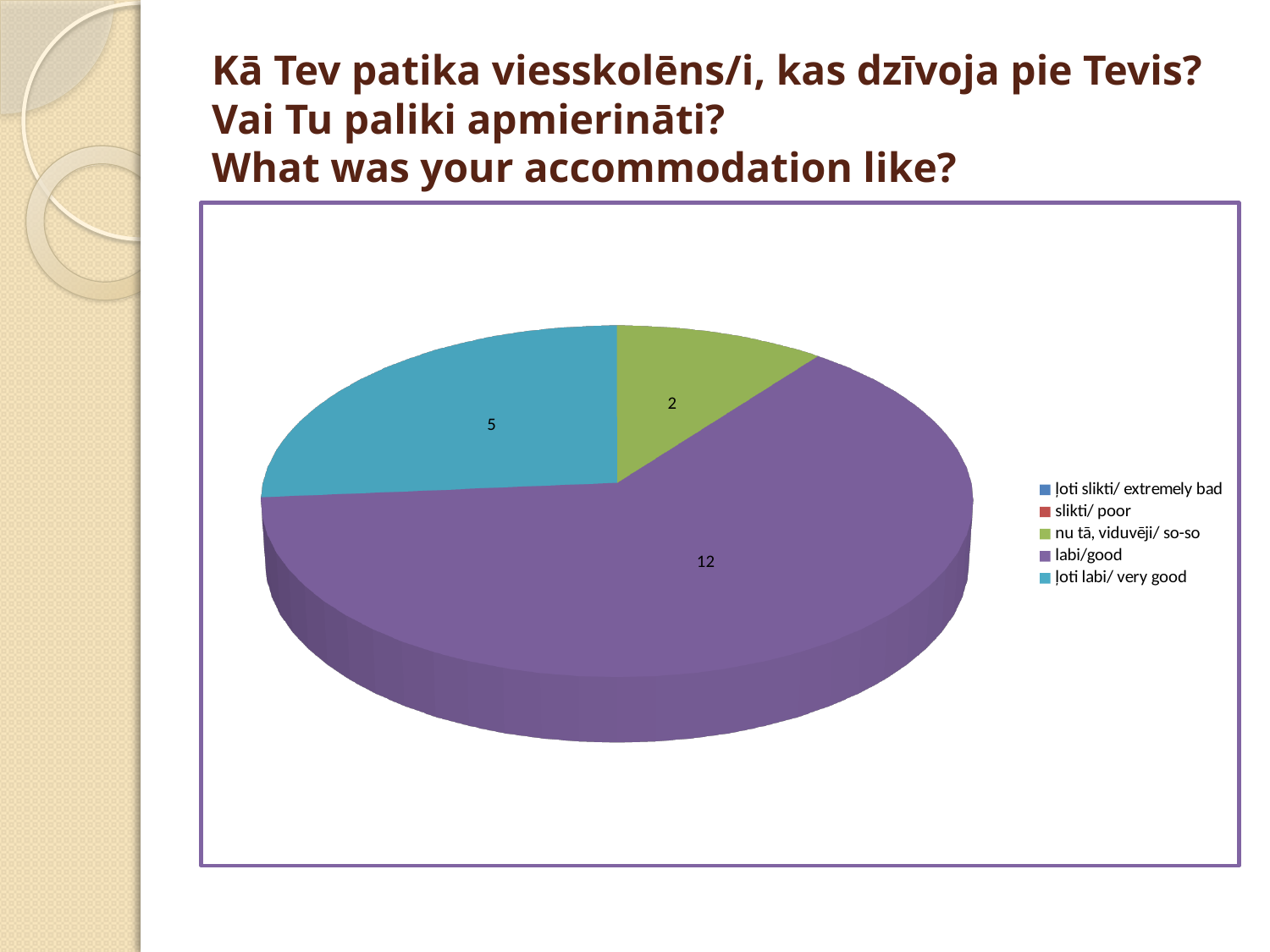
How many respondents rated their accommodation as labi/good? 12 Which rating category has the largest slice of the pie? labi/good What type of chart is shown on the slide? pie chart How many categories does the legend list? 5 Which of the visible slices is the smallest? nu tā, viduvēji/so-so What colour is the labi/good slice? purple What is the difference between the ļoti labi/very good and nu tā, viduvēji/so-so counts? 3 What is the difference between the number of labi/good responses and ļoti labi/very good responses? 7 Which is larger: the ļoti labi/very good slice or the nu tā, viduvēji/so-so slice? ļoti labi/very good What is the total number of responses shown in the pie chart? 19 How many respondents rated their accommodation as ļoti labi/very good? 5 How many respondents rated their accommodation as nu tā, viduvēji/so-so? 2